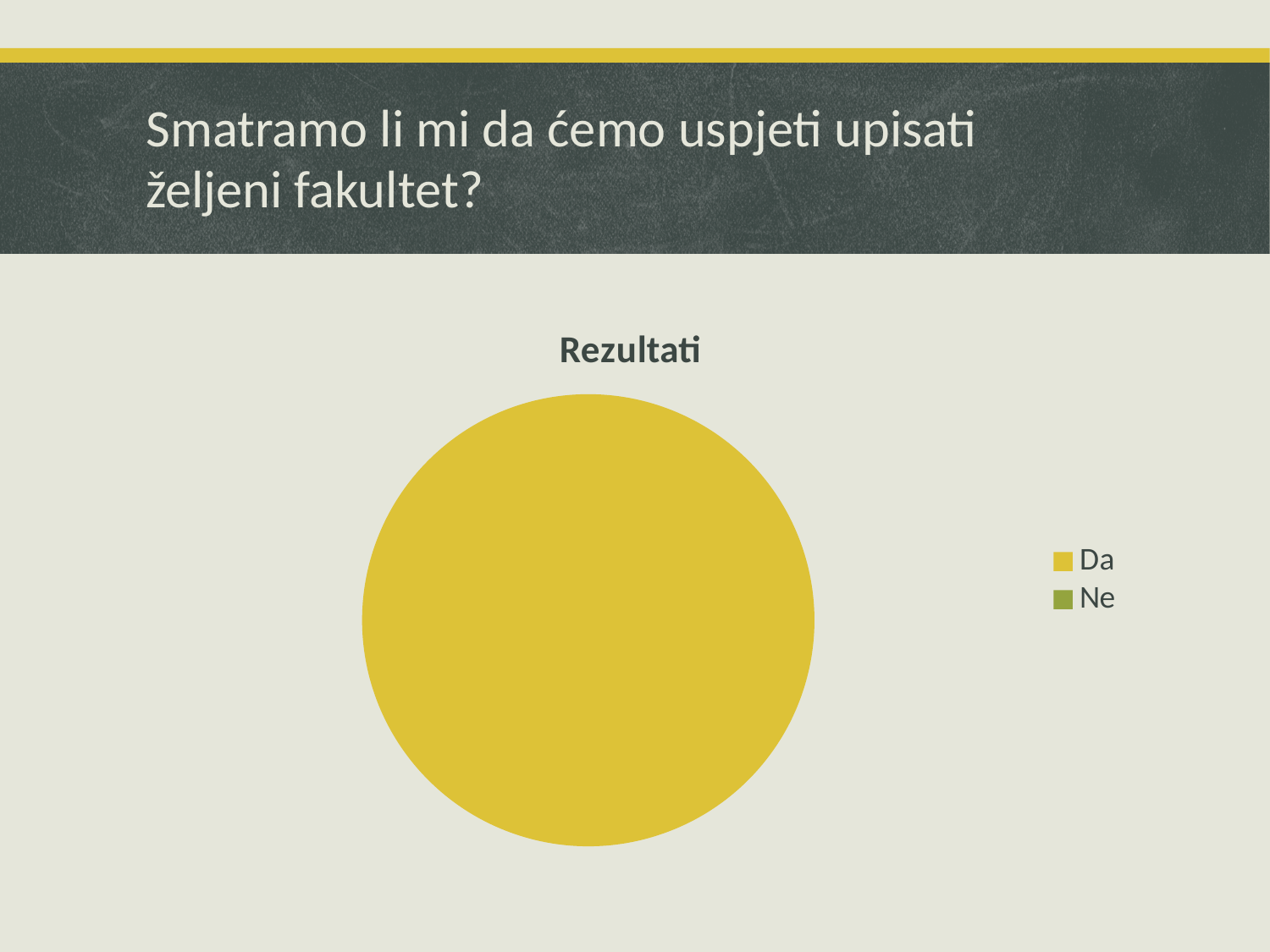
Which category has the larger share, Da or Ne? Da How many entries does the chart legend list? 2 What kind of chart is shown on the slide? pie chart Which category has the smallest share of the pie? Ne Which colour represents the category Da in the chart? yellow What is the title of the chart? Rezultati Which category has the largest share of the pie? Da